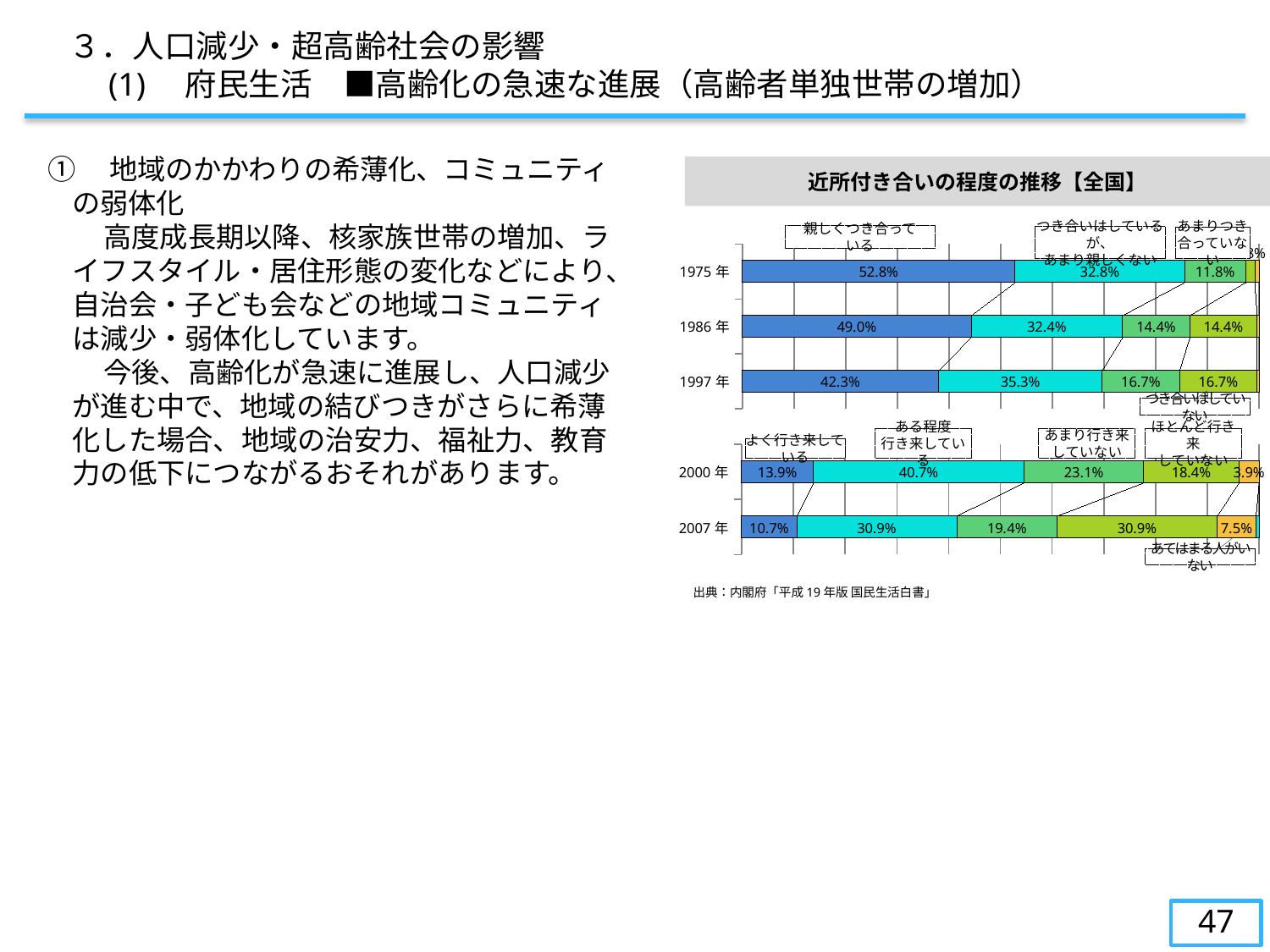
Among 1975年, 1986年 and 1997年, which year has the largest leftmost (blue) segment? 1975年 How many years (bars) are shown in the chart? 5 What is the value of the leftmost (blue) segment for 1975年? 52.8% What is the value of the leftmost (blue) segment for 1986年? 49.0% What is the value of the leftmost (blue) segment for 1997年? 42.3% What type of chart is shown on the slide? stacked bar chart What is the value of the leftmost (blue) segment for 2007年? 10.7% What is the value of the second segment (cyan) for 2000年? 40.7% What is the title of the chart? 近所付き合いの程度の推移【全国】 What is the difference between the leftmost (blue) segment values for 1975年 and 1997年? 10.5% Which is larger: the second segment (cyan) for 1997年 or for 2007年? 1997年 From 1975年 to 1997年, does the leftmost (blue) segment rise or fall? fall